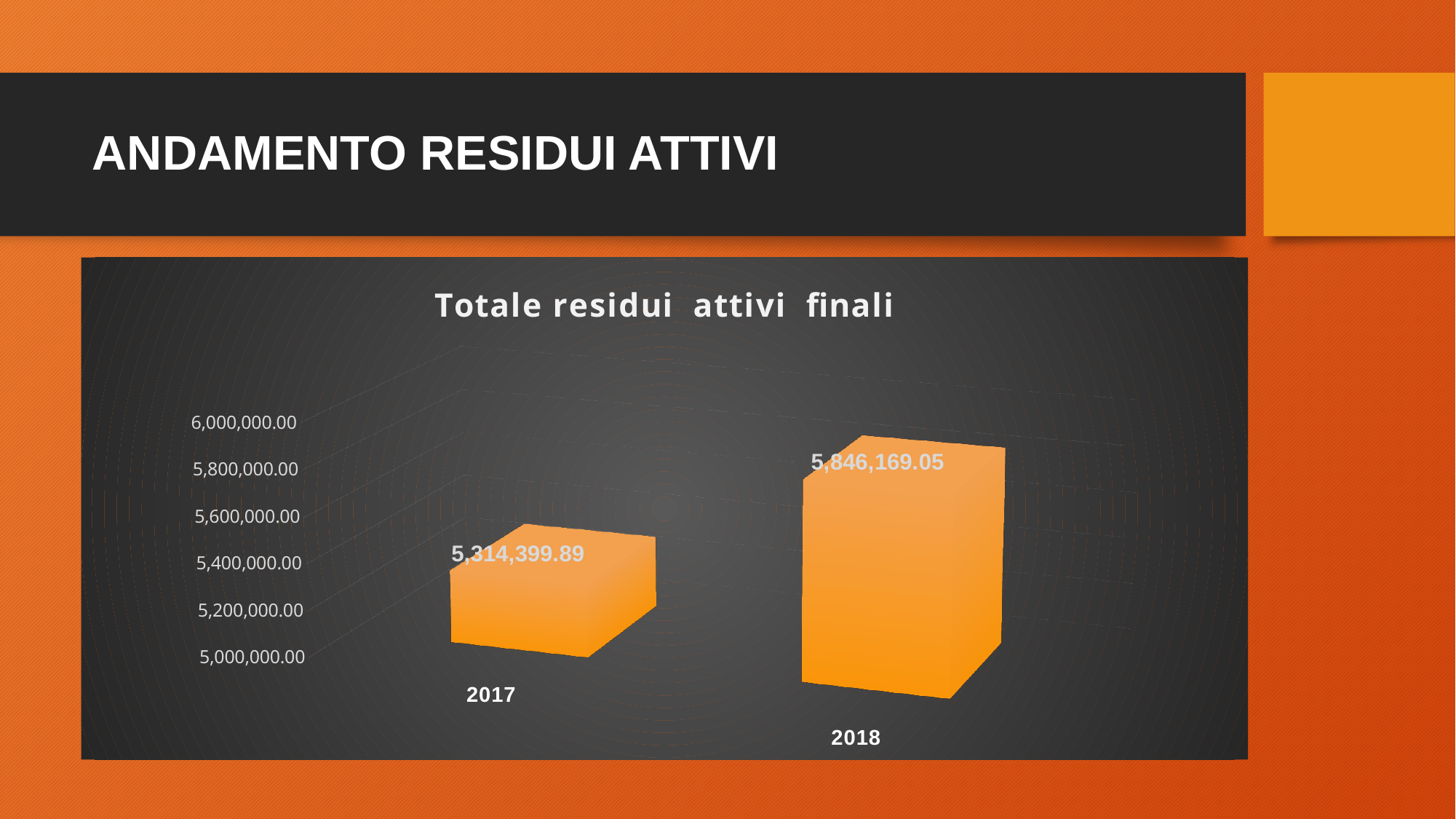
Which year has the lowest value? 2017 What is the title of the chart? Totale residui attivi finali What is the value for 2018? 5,846,169.05 How many years are shown on the chart? 2 Do the values rise or fall from 2017 to 2018? rise Which is larger, the value for 2017 or the value for 2018? 2018 What kind of chart is shown on the slide? bar chart Is the value for 2017 greater or less than 5,400,000.00? less What is the difference between the 2018 value and the 2017 value? 531,769.16 Is the value for 2018 greater or less than 5,800,000.00? greater Which year has the highest value? 2018 What is the value for 2017? 5,314,399.89